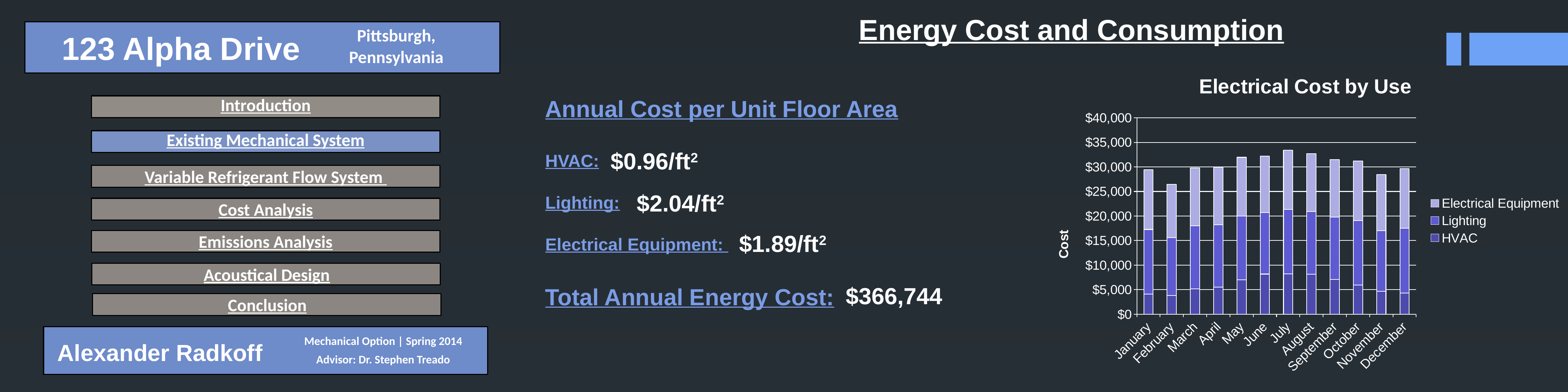
In the 'Electrical Cost by Use' chart, which month has a larger total electrical cost, July or February? July In the 'Electrical Cost by Use' chart, which month has the lowest total electrical cost? February In the 'Electrical Cost by Use' chart, is the HVAC cost for July greater or less than $5,000? greater How many months are shown on the x axis of the 'Electrical Cost by Use' chart? 12 In the 'Electrical Cost by Use' chart, is the total cost for May greater or less than $30,000? greater How many series does the legend of the 'Electrical Cost by Use' chart list? 3 In the 'Electrical Cost by Use' chart, is the total cost for July greater or less than $30,000? greater What are the three series listed in the legend of the 'Electrical Cost by Use' chart? Electrical Equipment, Lighting, HVAC What is the title of the chart on the slide? Electrical Cost by Use What kind of chart is the 'Electrical Cost by Use' chart? stacked bar chart In the 'Electrical Cost by Use' chart, which month has the highest total electrical cost? July